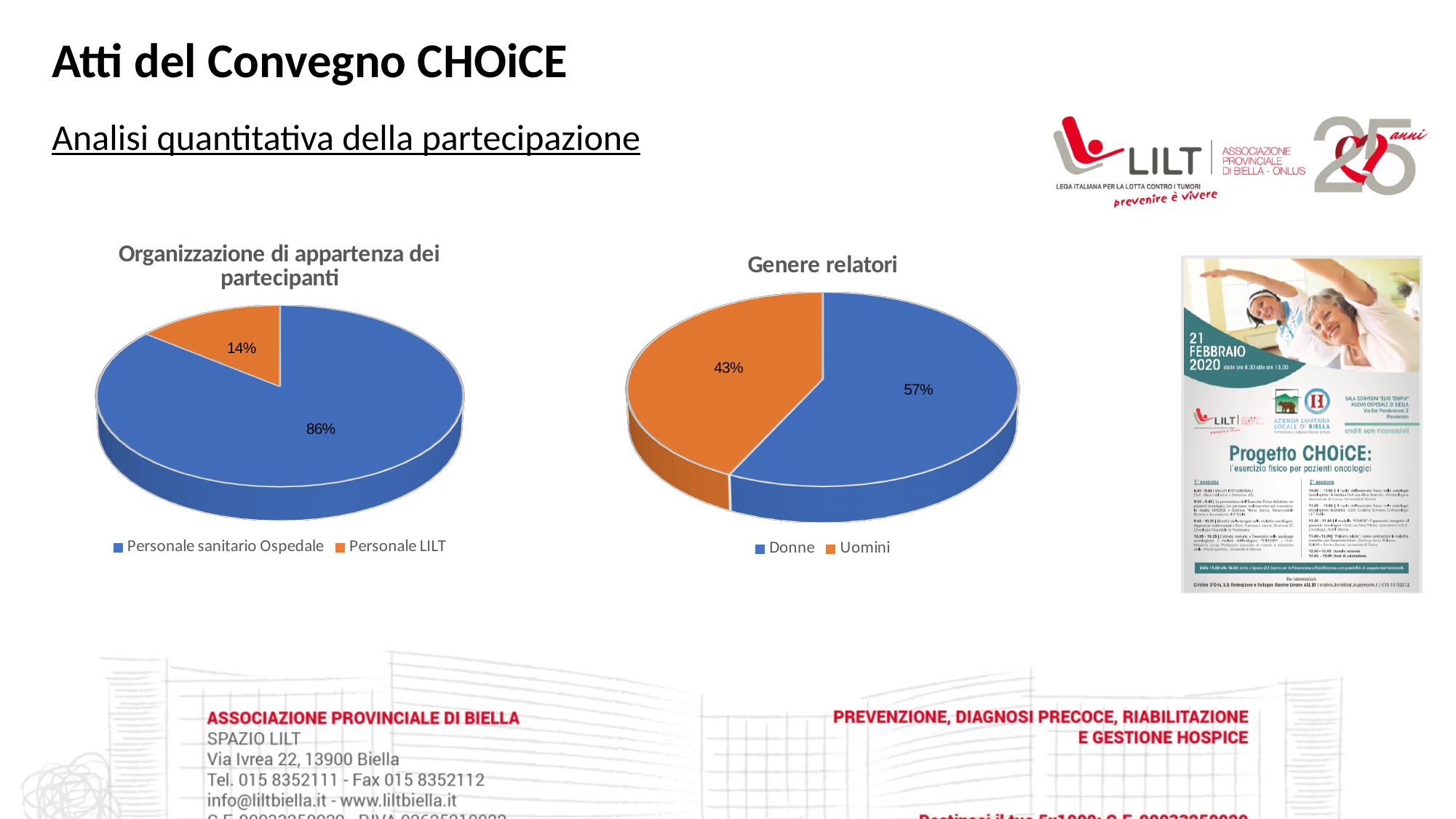
In the 'Organizzazione di appartenza dei partecipanti' chart, what share of participants is Personale LILT? 14% What colour is the Uomini slice in the 'Genere relatori' chart? Orange How many categories does the 'Organizzazione di appartenza dei partecipanti' chart show? 2 In the 'Genere relatori' chart, what is the difference in percentage points between Donne and Uomini? 14 What kind of chart is the 'Genere relatori' chart? Pie chart In the 'Organizzazione di appartenza dei partecipanti' chart, what share of participants is Personale sanitario Ospedale? 86% In the 'Genere relatori' chart, what percentage is Uomini? 43% In the 'Organizzazione di appartenza dei partecipanti' chart, what is the difference in percentage points between Personale sanitario Ospedale and Personale LILT? 72 In the 'Genere relatori' chart, what percentage is Donne? 57% In the 'Organizzazione di appartenza dei partecipanti' chart, which category has the largest share? Personale sanitario Ospedale In the 'Genere relatori' chart, which is larger, Donne or Uomini? Donne In the 'Genere relatori' chart, which category has the smallest share? Uomini